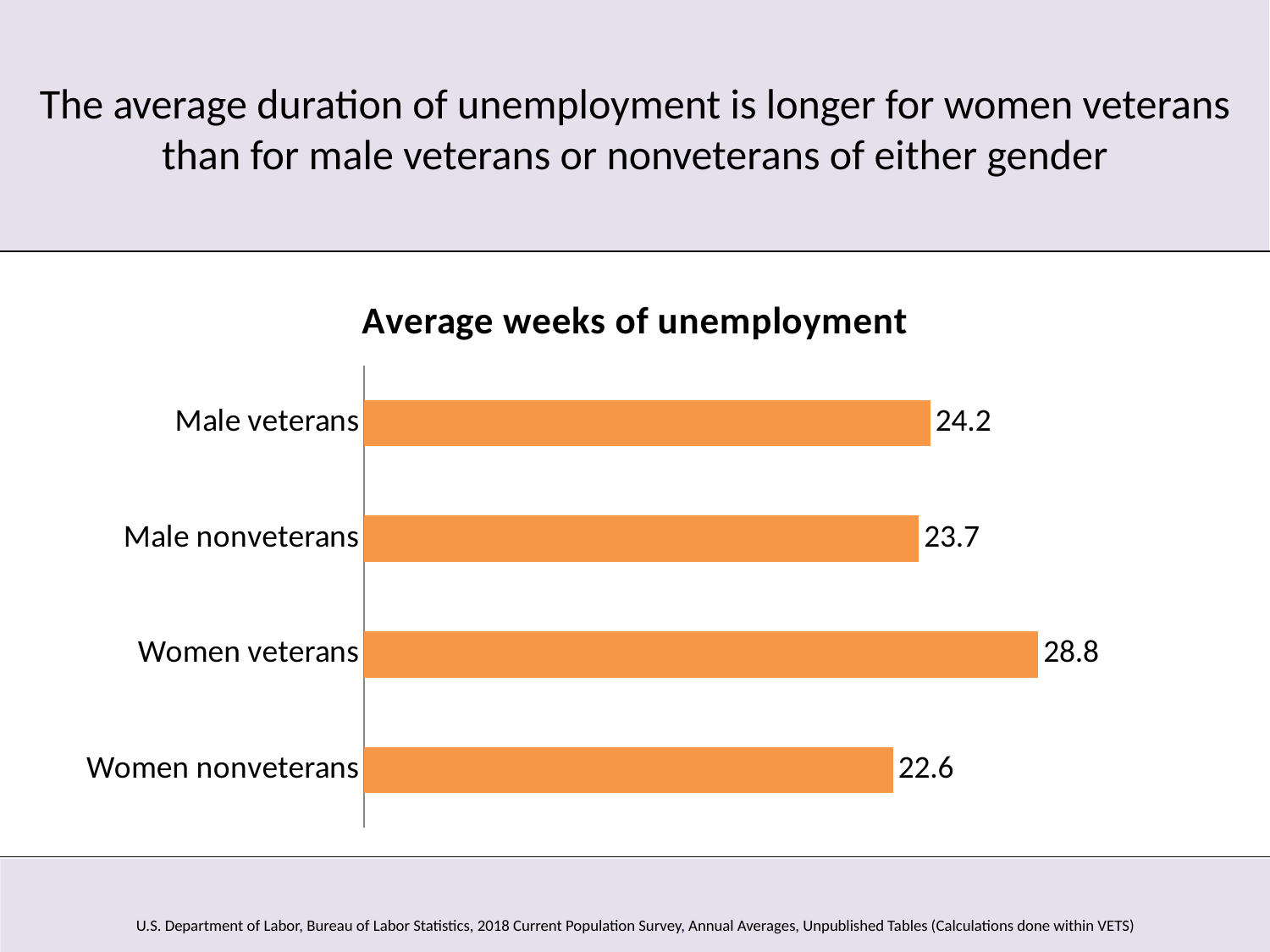
What kind of chart is shown on the slide? Bar chart What is the average weeks of unemployment for Male veterans? 24.2 What is the average weeks of unemployment for Women veterans? 28.8 Which has a higher average weeks of unemployment, Women veterans or Male veterans? Women veterans What is the difference in average weeks of unemployment between Male veterans and Male nonveterans? 0.5 What is the average weeks of unemployment for Male nonveterans? 23.7 Which category has the highest average weeks of unemployment? Women veterans What is the average weeks of unemployment for Women nonveterans? 22.6 How many categories are shown in the chart? 4 Which category has the lowest average weeks of unemployment? Women nonveterans What is the title of the chart? Average weeks of unemployment What is the difference in average weeks of unemployment between Women veterans and Women nonveterans? 6.2